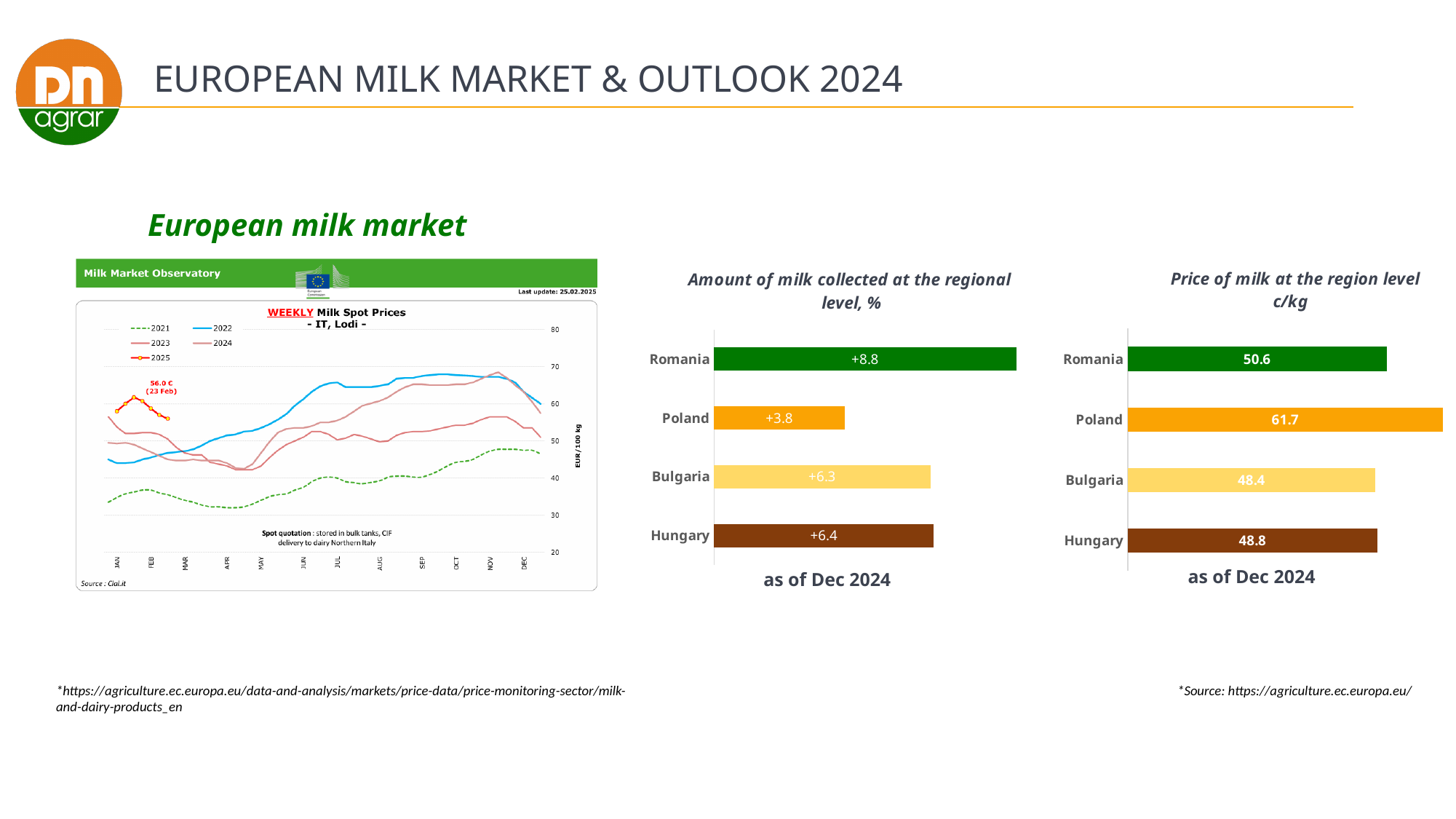
In the 'Price of milk at the region level c/kg' chart, what is the value for Poland? 61.7 In the 'Price of milk at the region level c/kg' chart, which country has the highest price? Poland In the 'Amount of milk collected at the regional level, %' chart, which country has the lowest value? Poland What kind of chart is the 'Weekly Milk Spot Prices - IT, Lodi' chart on the left? Line chart In the 'Price of milk at the region level c/kg' chart, how many countries are shown? 4 In the 'Weekly Milk Spot Prices - IT, Lodi' chart on the left, how many series does the legend list? 5 In the 'Price of milk at the region level c/kg' chart, what is the value for Hungary? 48.8 In the 'Amount of milk collected at the regional level, %' chart, what is the difference between Romania and Poland? 5.0 In the 'Amount of milk collected at the regional level, %' chart, what is the value for Romania? +8.8 In the 'Price of milk at the region level c/kg' chart, what is the difference between Poland and Bulgaria? 13.3 In the 'Price of milk at the region level c/kg' chart, which country has the lowest price? Bulgaria In the 'Amount of milk collected at the regional level, %' chart, what is the value for Poland? +3.8